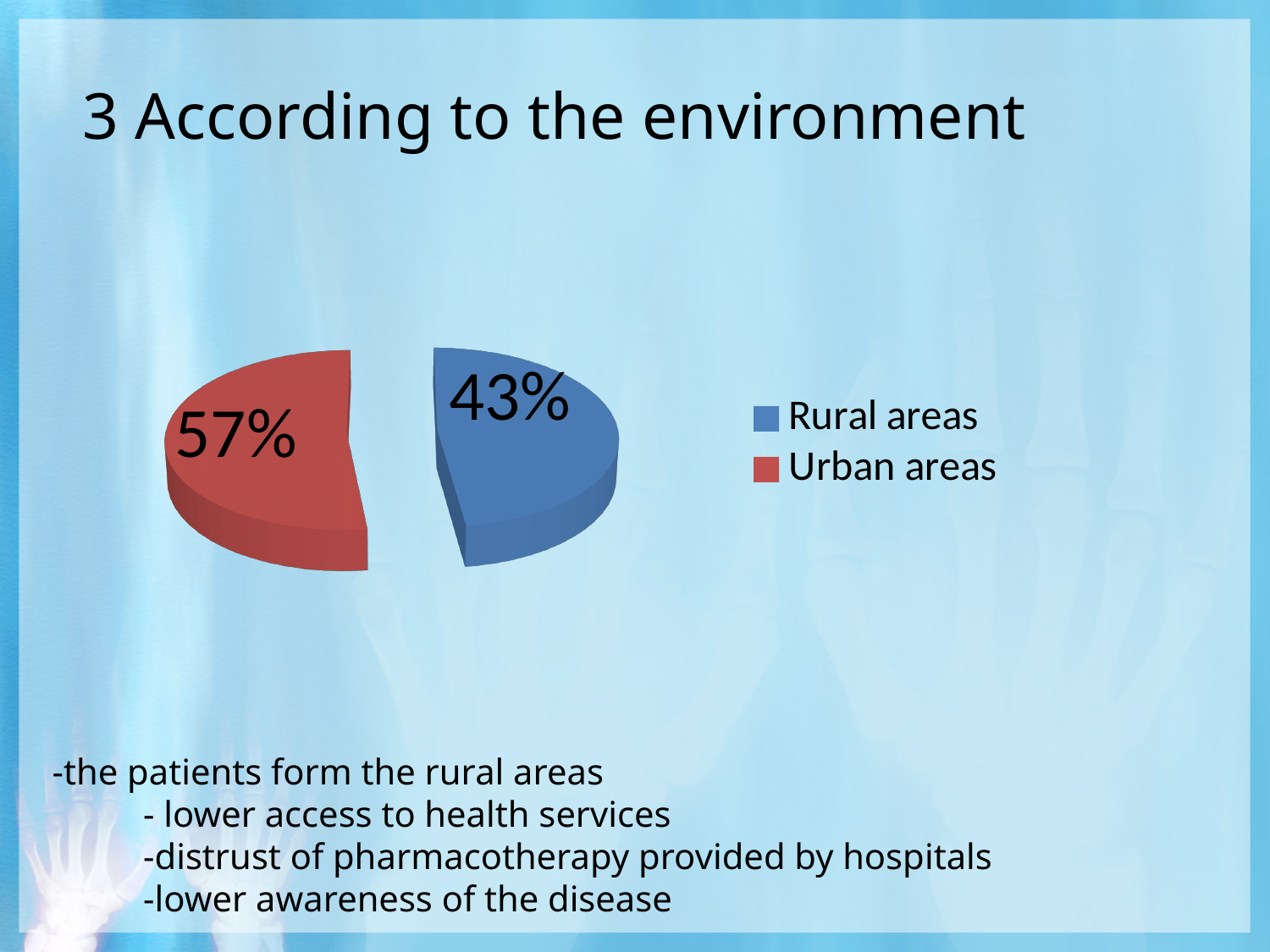
What percentage of the pie chart is Rural areas? 43% Which is larger, the share for Rural areas or the share for Urban areas? Urban areas What share of the pie does the Urban areas slice represent? 57% What percentage of the pie chart is Urban areas? 57% What colour is the Rural areas slice in the pie chart? Blue How many slices does the pie chart have? 2 What kind of chart is shown on the slide? Pie chart Which category has the smallest share of the pie chart? Rural areas What is the difference in percentage points between Urban areas and Rural areas? 14 How many entries does the legend list? 2 Which category has the largest share of the pie chart? Urban areas